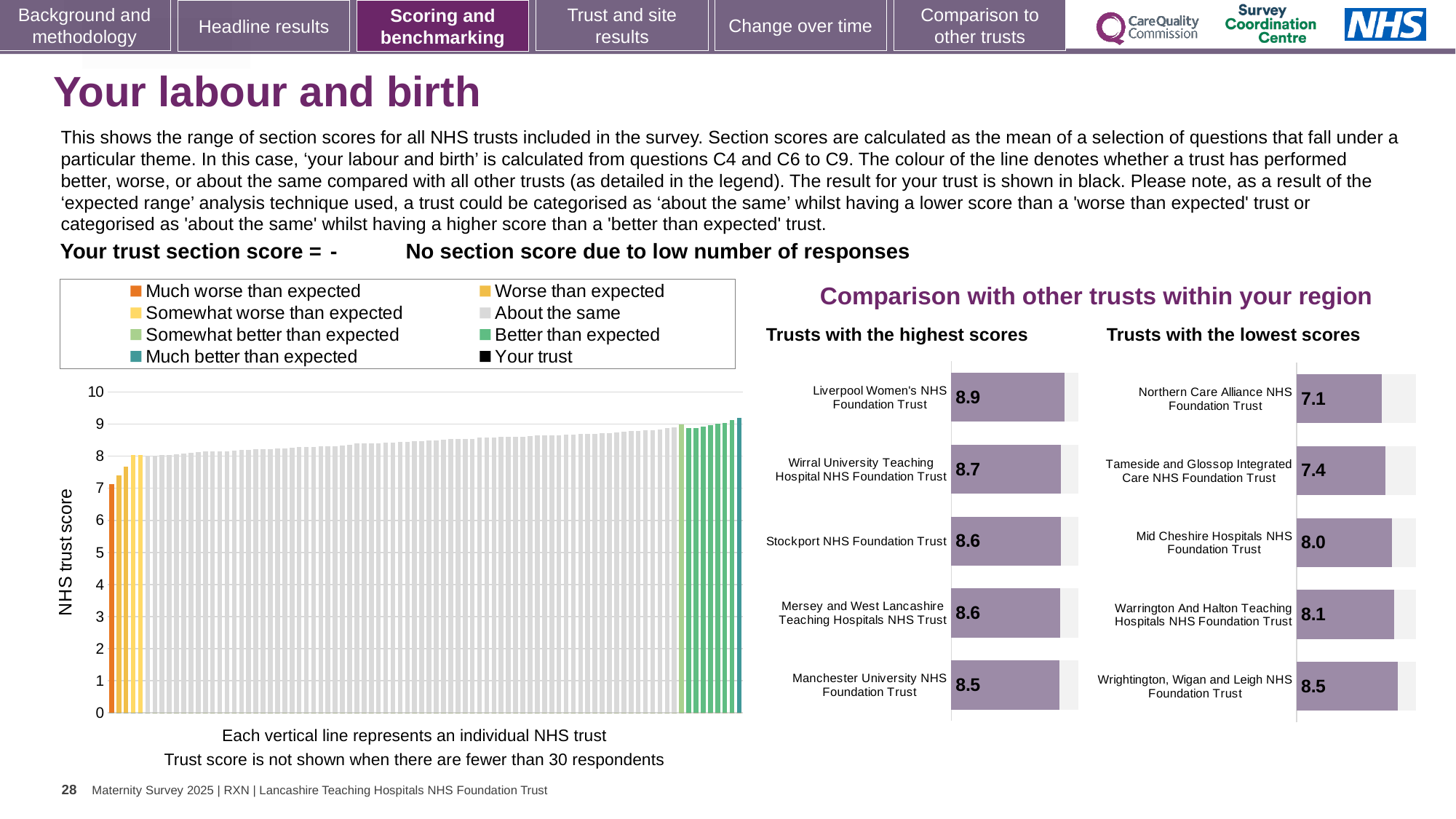
In the 'Trusts with the lowest scores' chart, which trust has the lowest score? Northern Care Alliance NHS Foundation Trust In the 'Trusts with the highest scores' chart, which trust has the highest score? Liverpool Women's NHS Foundation Trust In the 'Trusts with the highest scores' chart, what is the difference between the scores of Liverpool Women's NHS Foundation Trust and Manchester University NHS Foundation Trust? 0.4 In the 'Trusts with the lowest scores' chart, which has the larger score: Mid Cheshire Hospitals NHS Foundation Trust or Warrington And Halton Teaching Hospitals NHS Foundation Trust? Warrington And Halton Teaching Hospitals NHS Foundation Trust In the 'Trusts with the lowest scores' chart, what is the score for Tameside and Glossop Integrated Care NHS Foundation Trust? 7.4 In the 'Trusts with the lowest scores' chart, what is the score for Wrightington, Wigan and Leigh NHS Foundation Trust? 8.5 What kind of chart is the 'NHS trust score' chart on the left of the slide? Bar chart How many entries does the legend above the 'NHS trust score' chart list? 8 How many trusts are listed in the 'Trusts with the lowest scores' chart? 5 In the 'NHS trust score' chart on the left, do the bars rise or fall from left to right? Rise In the 'Trusts with the highest scores' chart, what is the score for Liverpool Women's NHS Foundation Trust? 8.9 In the 'NHS trust score' chart on the left, is the value of the leftmost (orange) bar greater or less than 8? less